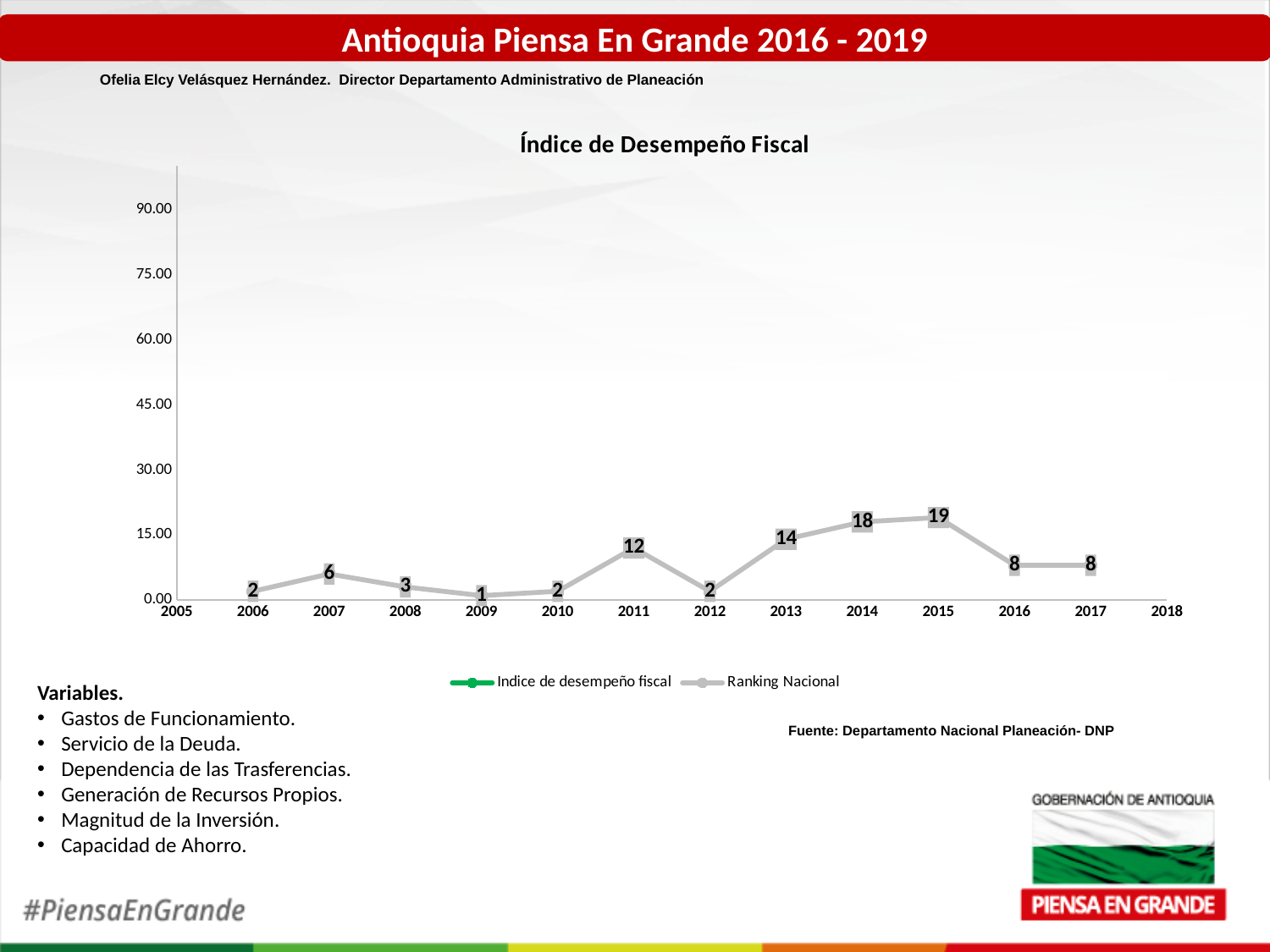
What is the Ranking Nacional value for 2011? 12 How many data points are labelled on the Ranking Nacional line? 12 What type of chart is shown on the slide? line chart What is the Ranking Nacional value for 2009? 1 What is the title of the chart? Índice de Desempeño Fiscal What is the Ranking Nacional value for 2015? 19 Is the Ranking Nacional value for 2014 greater or less than 15.00? greater What is the difference between the Ranking Nacional values for 2015 and 2016? 11 How many series does the legend list? 2 In which year is the Ranking Nacional value highest? 2015 Which year has a larger Ranking Nacional value, 2013 or 2014? 2014 In which year is the Ranking Nacional value lowest? 2009